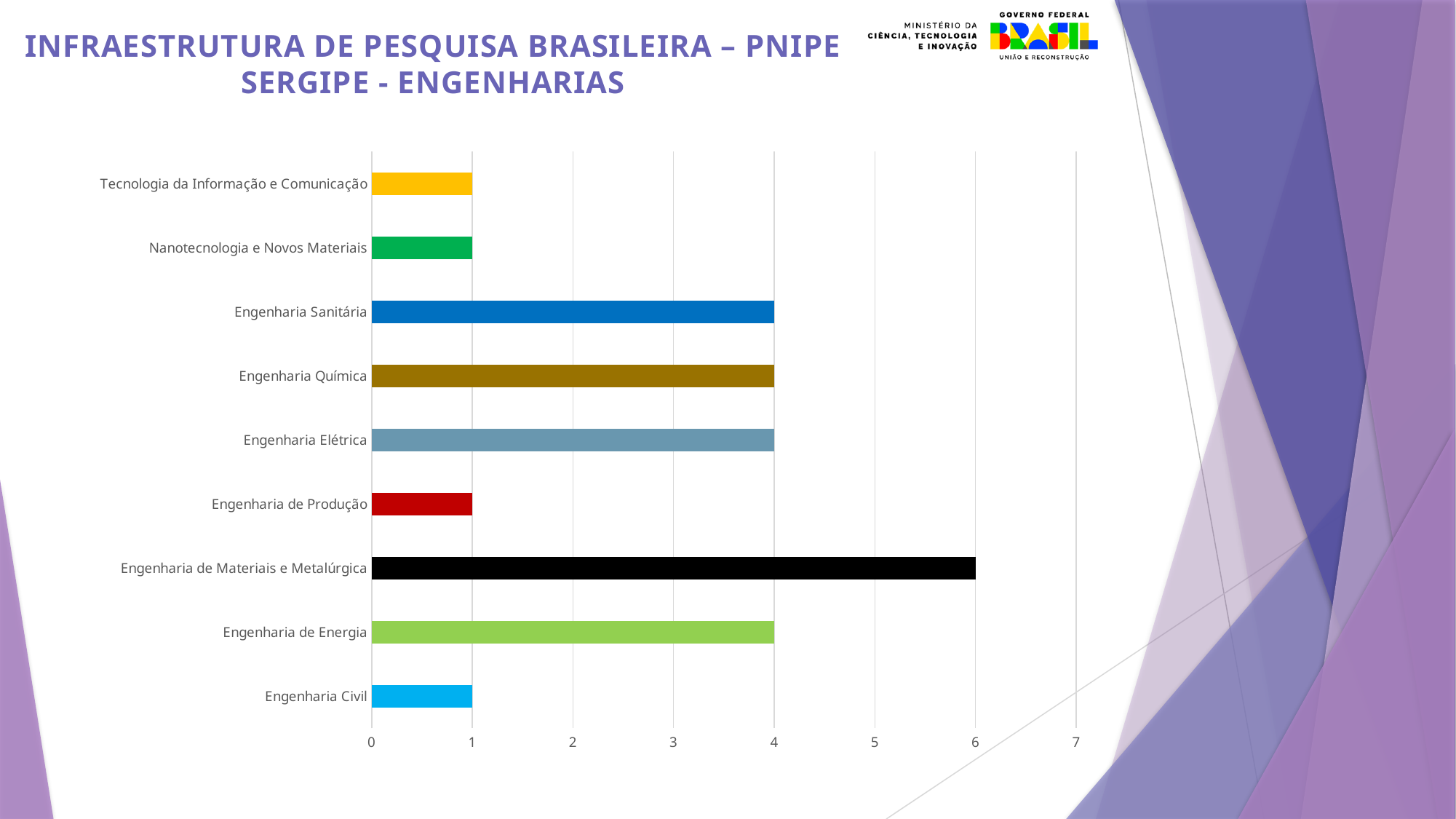
What is the value for Engenharia Química? 4 What is the value for Engenharia de Energia? 4 What colour is the bar for Engenharia de Materiais e Metalúrgica? black What is the value for Engenharia de Materiais e Metalúrgica? 6 Which is larger, the value for Engenharia Elétrica or the value for Nanotecnologia e Novos Materiais? Engenharia Elétrica What is the value for Engenharia Civil? 1 What is the difference between the values for Engenharia Sanitária and Engenharia de Produção? 3 Which category has the highest value in the chart? Engenharia de Materiais e Metalúrgica What kind of chart is shown on the slide? bar chart What is the difference between the values for Engenharia de Materiais e Metalúrgica and Engenharia Elétrica? 2 How many categories are plotted in the chart? 9 Is the value for Engenharia de Materiais e Metalúrgica greater or less than 5? greater